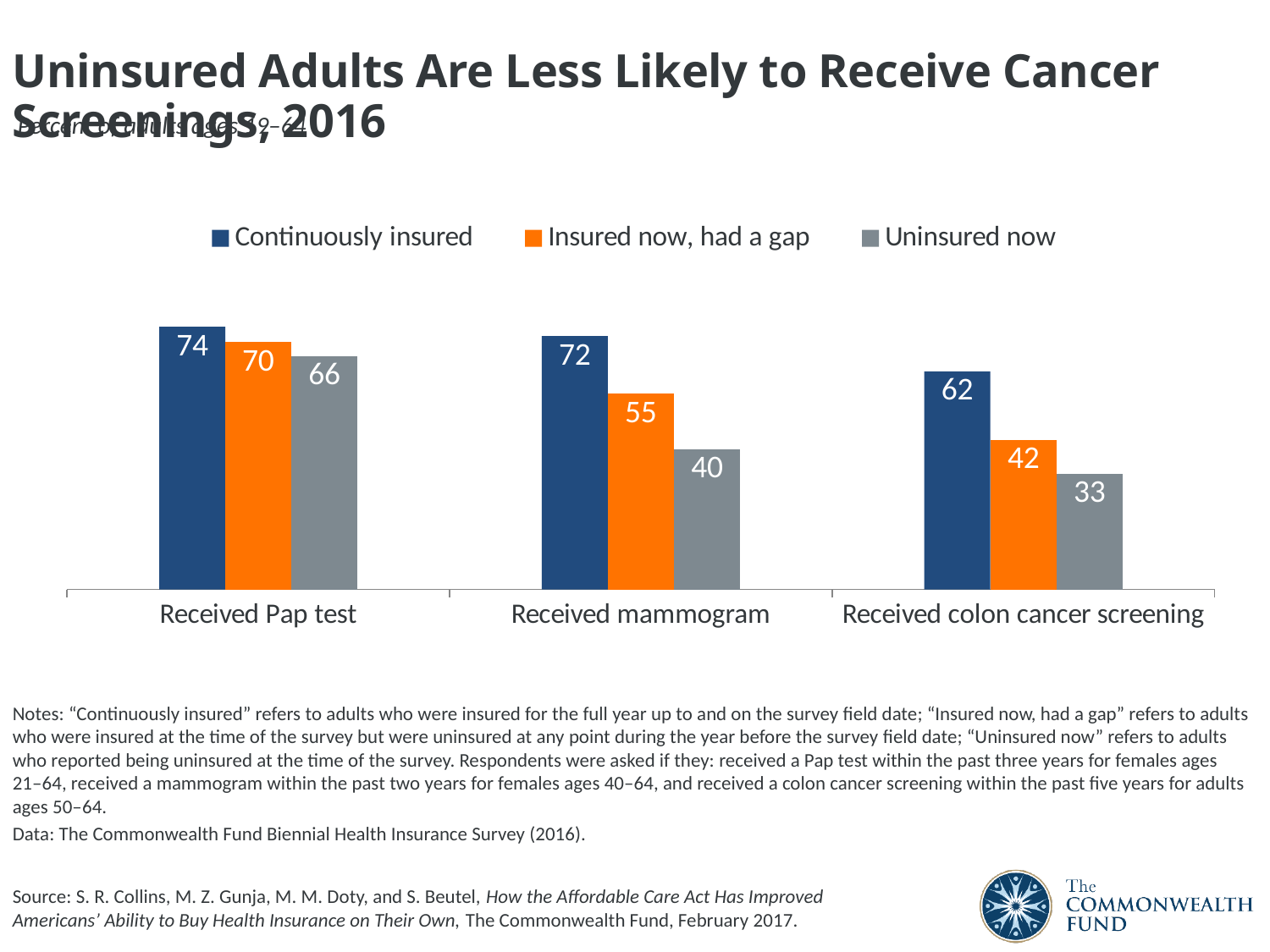
What is the difference between Continuously insured and Uninsured now for Received mammogram? 32 Which category has the lowest value for the Uninsured now series? Received colon cancer screening How many categories are shown on the x axis? 3 Which category has the highest value for the Continuously insured series? Received Pap test What is the difference between Continuously insured and Uninsured now for Received colon cancer screening? 29 What kind of chart is shown on the slide? Bar chart What is the value for Insured now, had a gap adults who received colon cancer screening? 42 What is the value for Continuously insured adults who received a Pap test? 74 Which series is shown in orange in the legend? Insured now, had a gap How many series does the legend list? 3 Which is larger: Insured now, had a gap for Received Pap test or Insured now, had a gap for Received mammogram? Received Pap test What is the value for Uninsured now adults who received a mammogram? 40